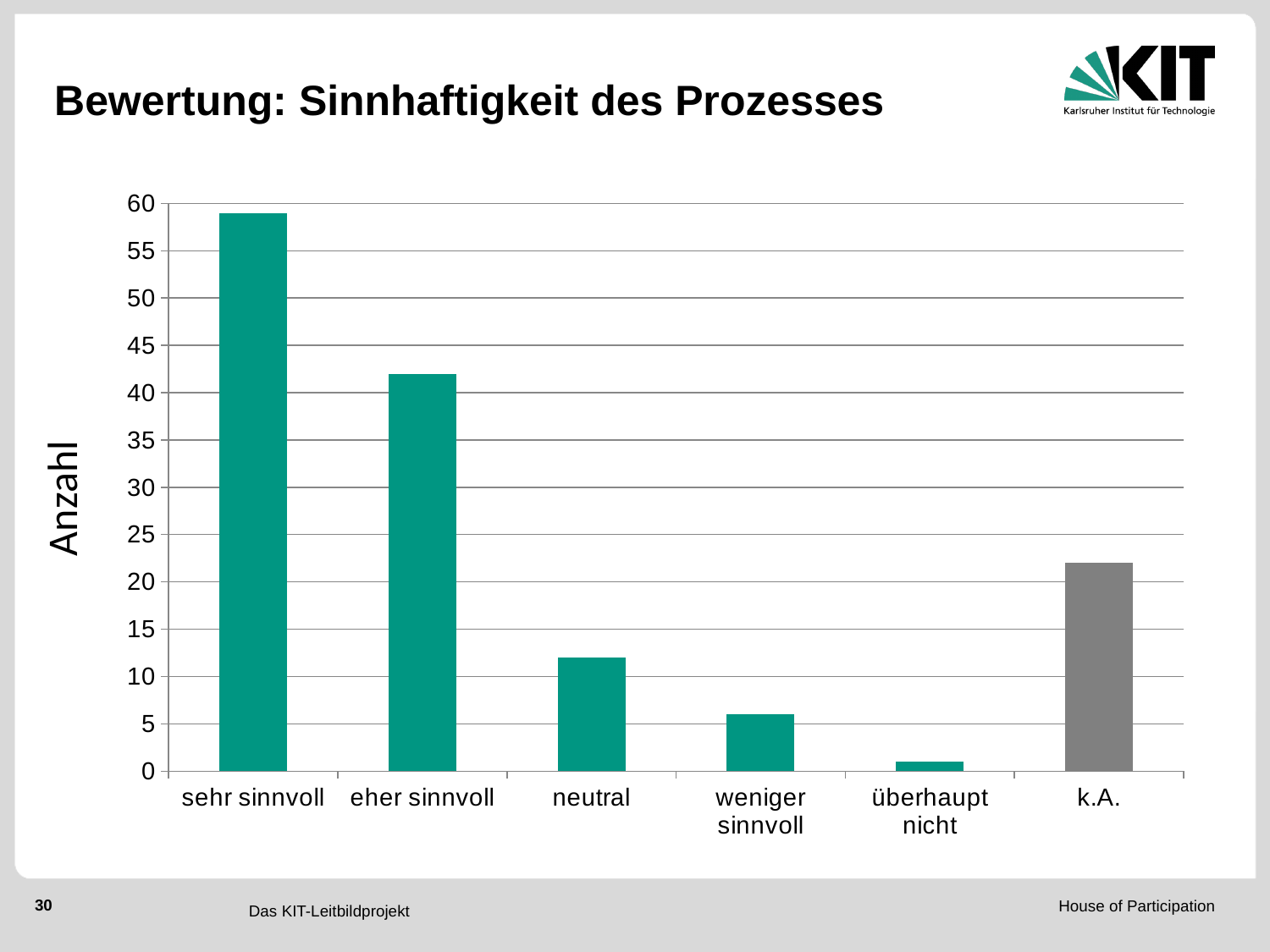
Is the value for sehr sinnvoll greater or less than 55? greater Is the value for weniger sinnvoll greater or less than 10? less Which category has the lowest value in the chart? überhaupt nicht Which category has the highest value in the chart? sehr sinnvoll How many categories are shown on the x axis of the chart? 6 Is the value for eher sinnvoll greater or less than 40? greater Which is larger, the value for k.A. or the value for neutral? k.A. What is the label of the y axis of the chart? Anzahl Which bar in the chart is coloured grey rather than green? k.A. What kind of chart is shown on the slide? bar chart